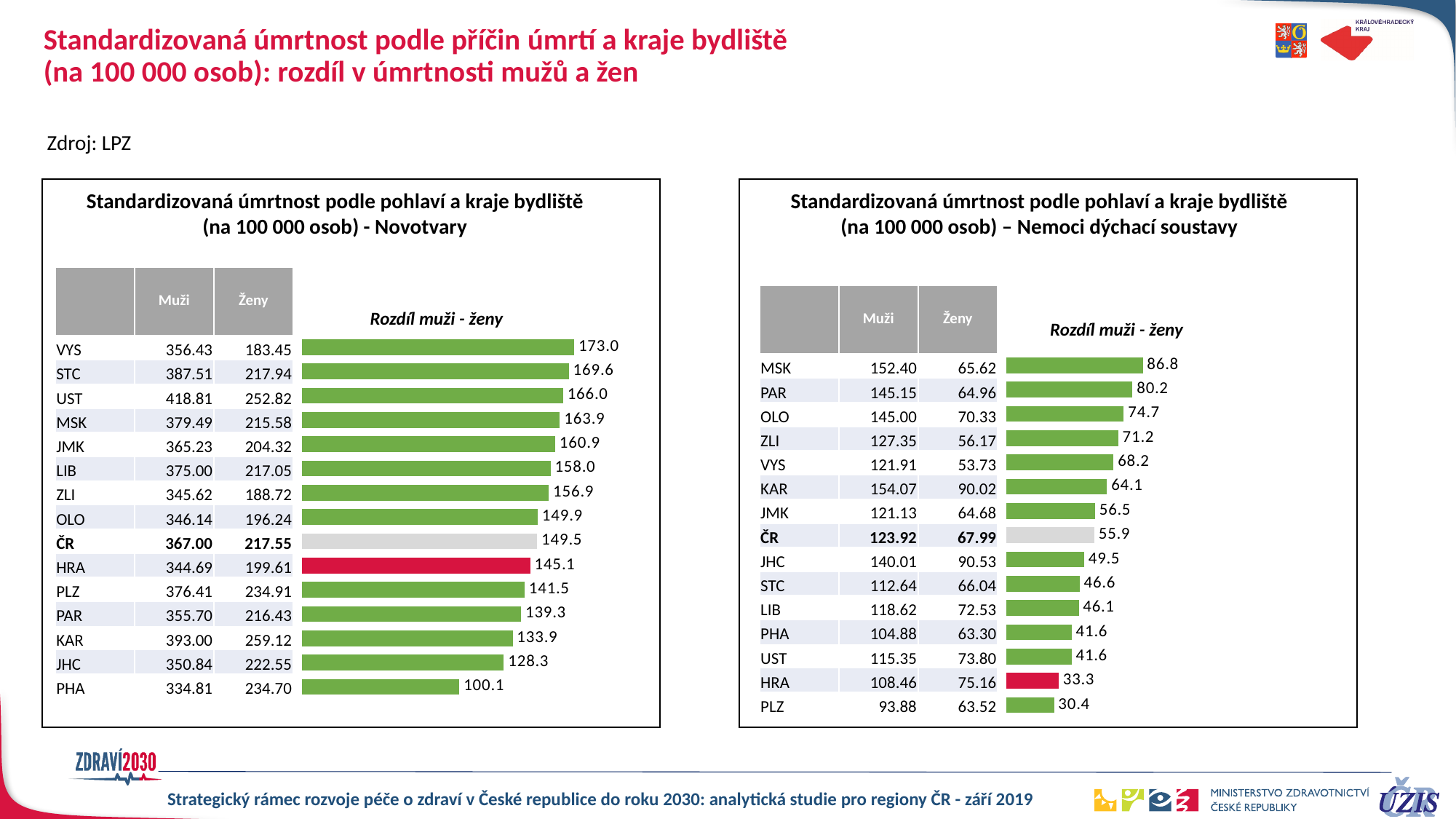
In the Novotvary chart, which region's bar is coloured red? HRA In the Nemoci dýchací soustavy chart, what is the difference shown for MSK? 86.8 In the Novotvary chart, which region has the largest difference between men and women? VYS What type of chart is used on the right side of the slide to show Rozdíl muži - ženy? Bar chart In the Nemoci dýchací soustavy chart, which has the larger difference, KAR or JMK? KAR In the Nemoci dýchací soustavy chart, which region has the smallest difference between men and women? PLZ In the Novotvary chart, what is the Muži value for HRA? 344.69 In the Novotvary chart, which region has the smallest difference between men and women? PHA In the Nemoci dýchací soustavy chart, how much larger is the difference for MSK than for PLZ? 56.4 In the Novotvary chart, what is the difference (Rozdíl muži - ženy) shown for VYS? 173.0 In the Nemoci dýchací soustavy chart, what is the Ženy value for HRA? 75.16 In the Novotvary chart, how many rows (regions including ČR) are plotted? 15